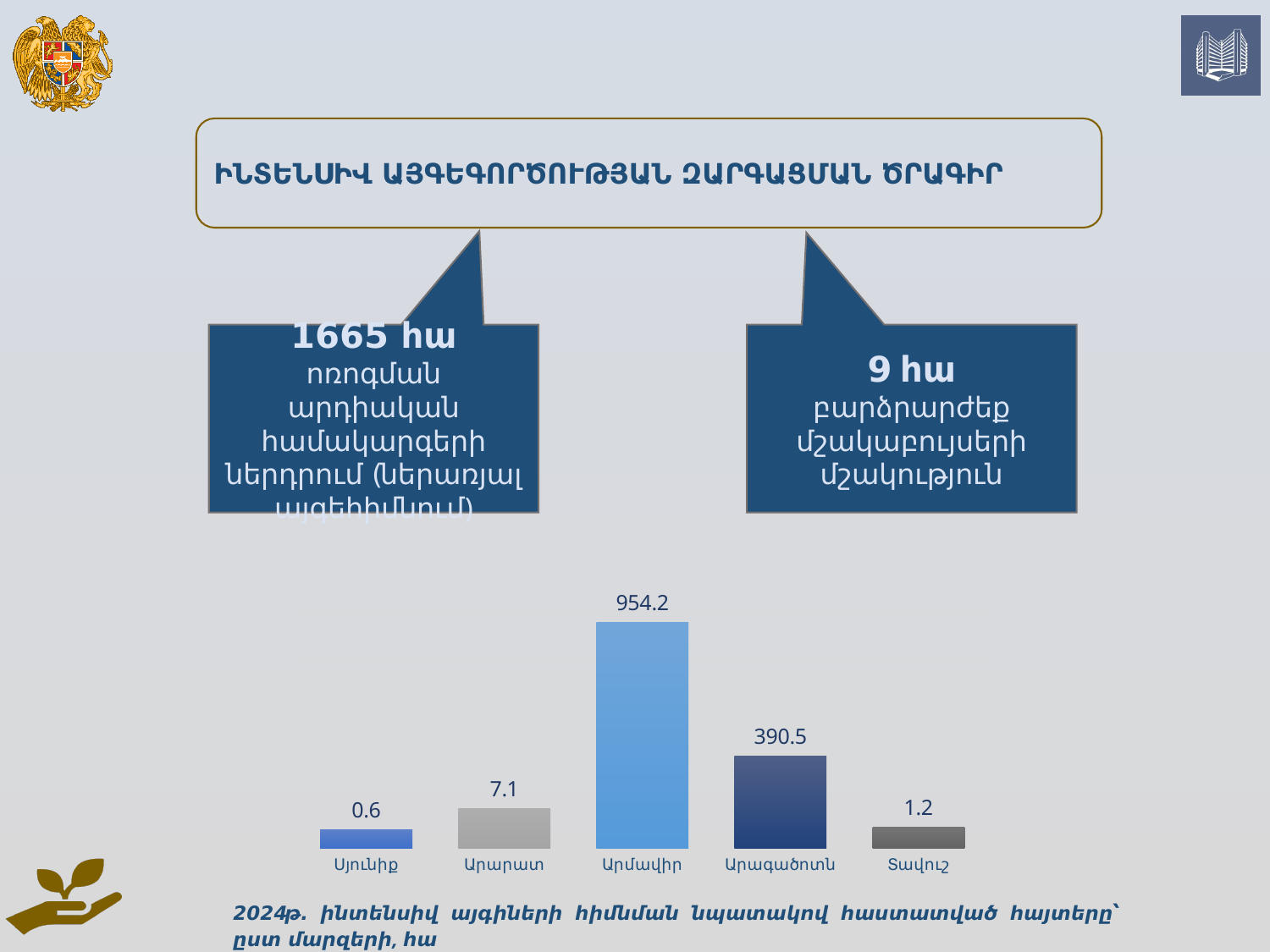
What is the difference between the values for Արմավիր and Արագածոտն? 563.7 What is the value for Արարատ in the bar chart? 7.1 Which is larger, the value for Արարատ or the value for Տավուշ? Արարատ What is the value for Տավուշ in the bar chart? 1.2 Which region has the highest value in the bar chart? Արմավիր What is the value for Արմավիր in the bar chart? 954.2 What is the value for Արագածոտն in the bar chart? 390.5 How many regions are shown in the bar chart? 5 What kind of chart is shown on the slide? Bar chart What is the difference between the values for Արարատ and Սյունիք? 6.5 Which region has the lowest value in the bar chart? Սյունիք What is the value for Սյունիք in the bar chart? 0.6